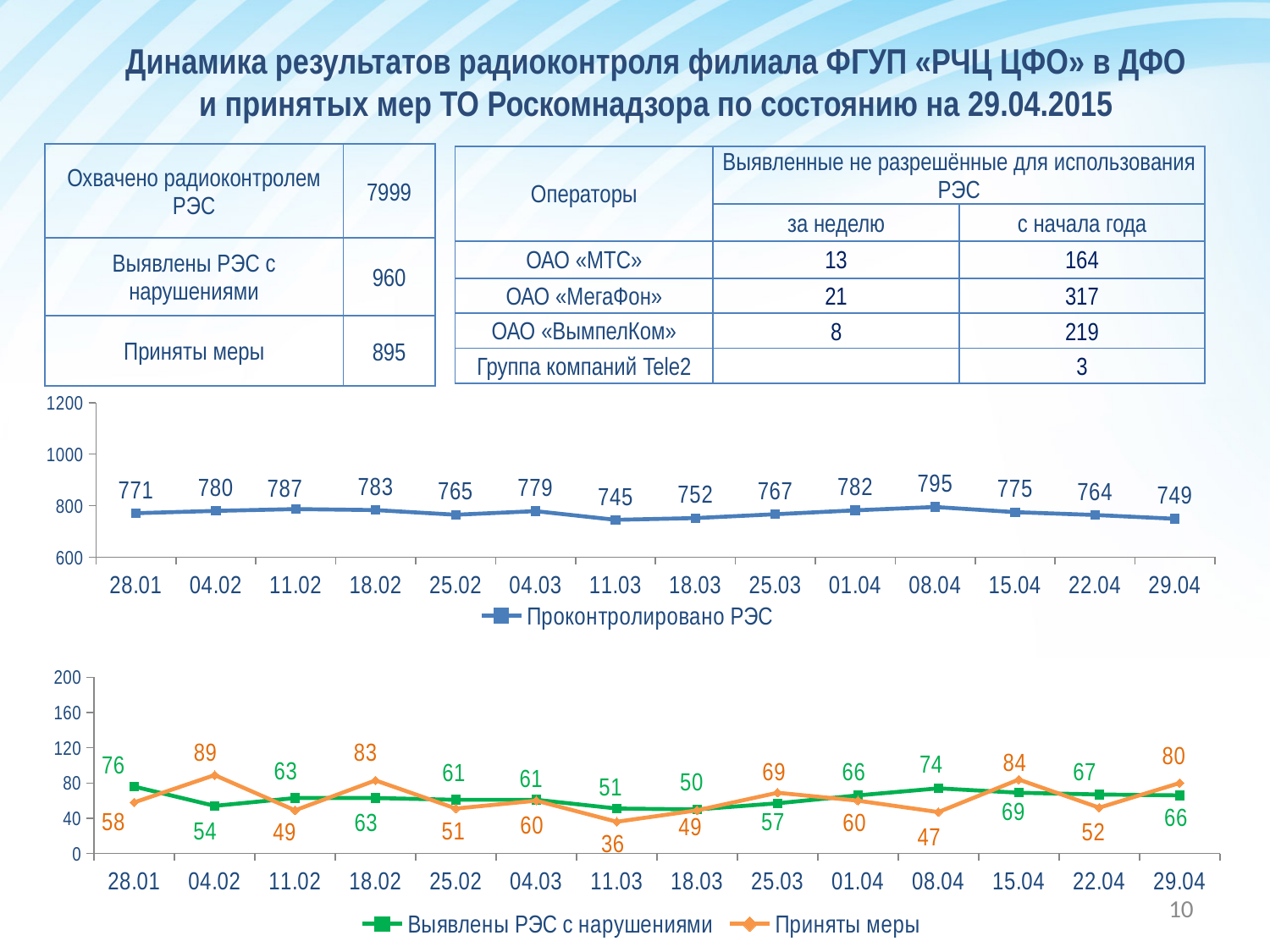
How many series does the legend of the bottom chart list? 2 In the bottom chart, on which date is Приняты меры lowest? 11.03 How many data points are plotted in the top chart? 14 In the bottom chart, what is the value of Приняты меры on 04.02? 89 In the top chart, on which date is Проконтролировано РЭС lowest? 11.03 In the bottom chart, which is larger on 18.02: Выявлены РЭС с нарушениями or Приняты меры? Приняты меры In the bottom chart, what is the value of Выявлены РЭС с нарушениями on 11.03? 51 In the top chart, what is the value of Проконтролировано РЭС on 08.04? 795 What type of chart is the top chart? Line chart In the top chart, on which date is Проконтролировано РЭС highest? 08.04 In the bottom chart, what is the difference between Выявлены РЭС с нарушениями and Приняты меры on 08.04? 27 In the top chart, what is the difference between the values on 28.01 and 29.04? 22